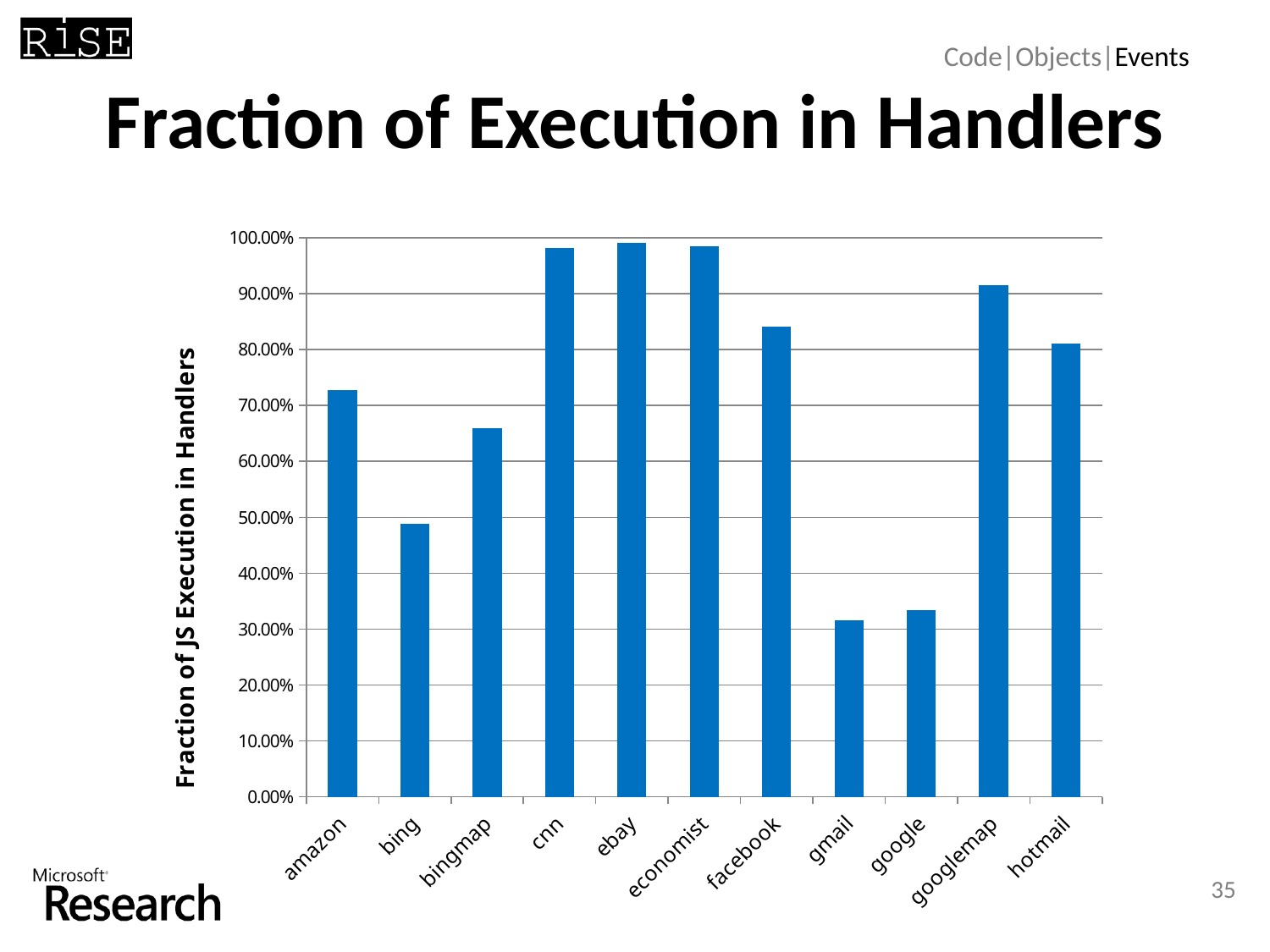
Is the value for bing greater or less than 50.00%? less What is the label on the vertical axis of the chart? Fraction of JS Execution in Handlers Which has a higher fraction of JS execution in handlers, amazon or bing? amazon Is the value for facebook greater or less than 80.00%? greater Is the value for amazon greater or less than 70.00%? greater What is the title of the slide containing the chart? Fraction of Execution in Handlers How many websites (categories) are plotted on the x axis? 11 Which has a higher fraction of JS execution in handlers, hotmail or google? hotmail What kind of chart is shown on the slide? bar chart